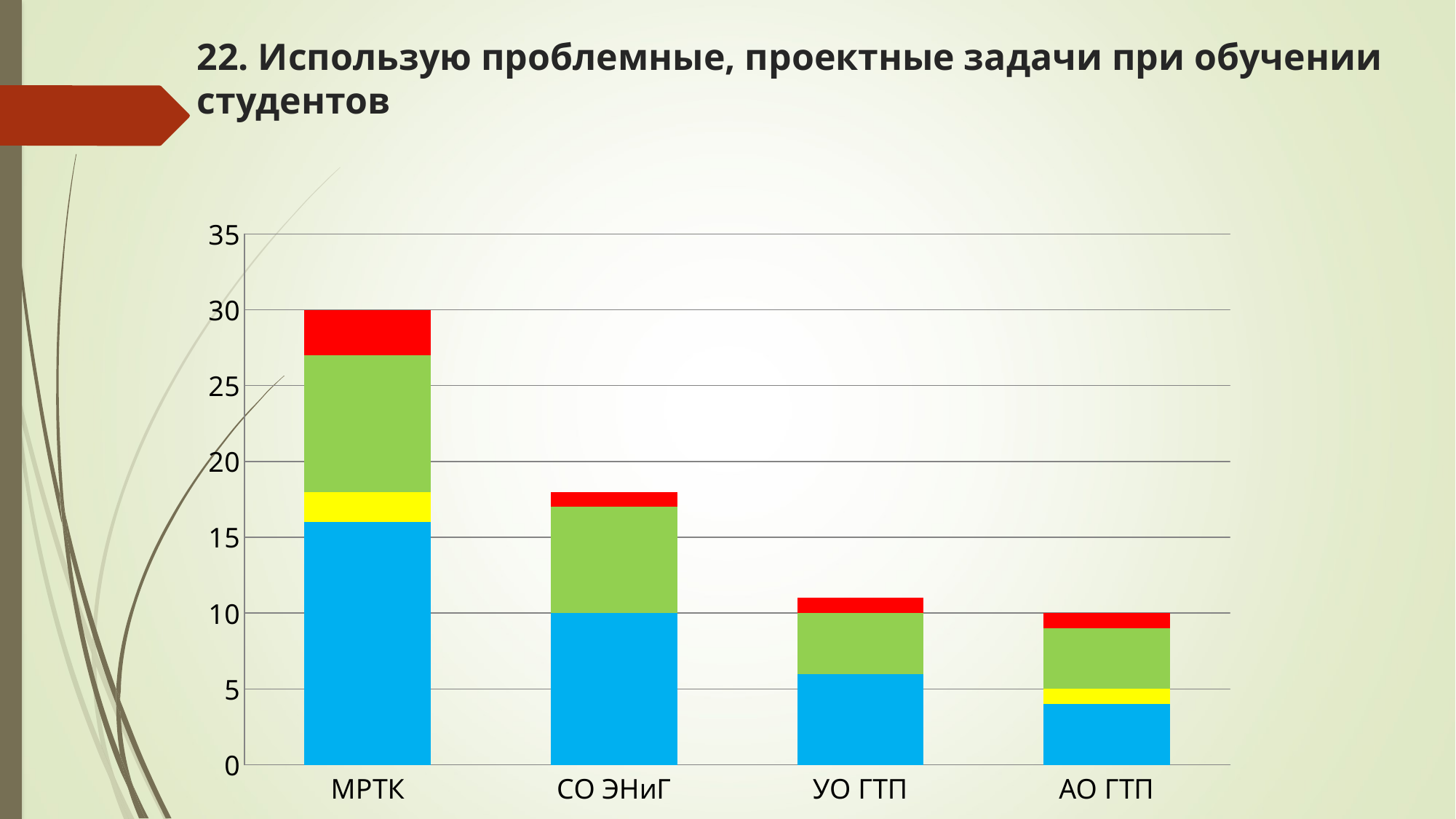
Which has a larger total, МРТК or СО ЭНиГ? МРТК Is the total for УО ГТП greater or less than 15? less What kind of chart is shown on the slide? stacked bar chart Is the total for СО ЭНиГ greater or less than 15? greater What is the total height of the stacked bar for АО ГТП? 10 Do the bar totals rise or fall from left to right along the x axis? fall What is the value of the blue (bottom) segment for СО ЭНиГ? 10 Which category has the tallest stacked bar? МРТК What is the difference between the total for МРТК and the total for АО ГТП? 20 Which category has the shortest stacked bar? АО ГТП How many categories are shown on the x axis of the chart? 4 What is the total height of the stacked bar for МРТК? 30